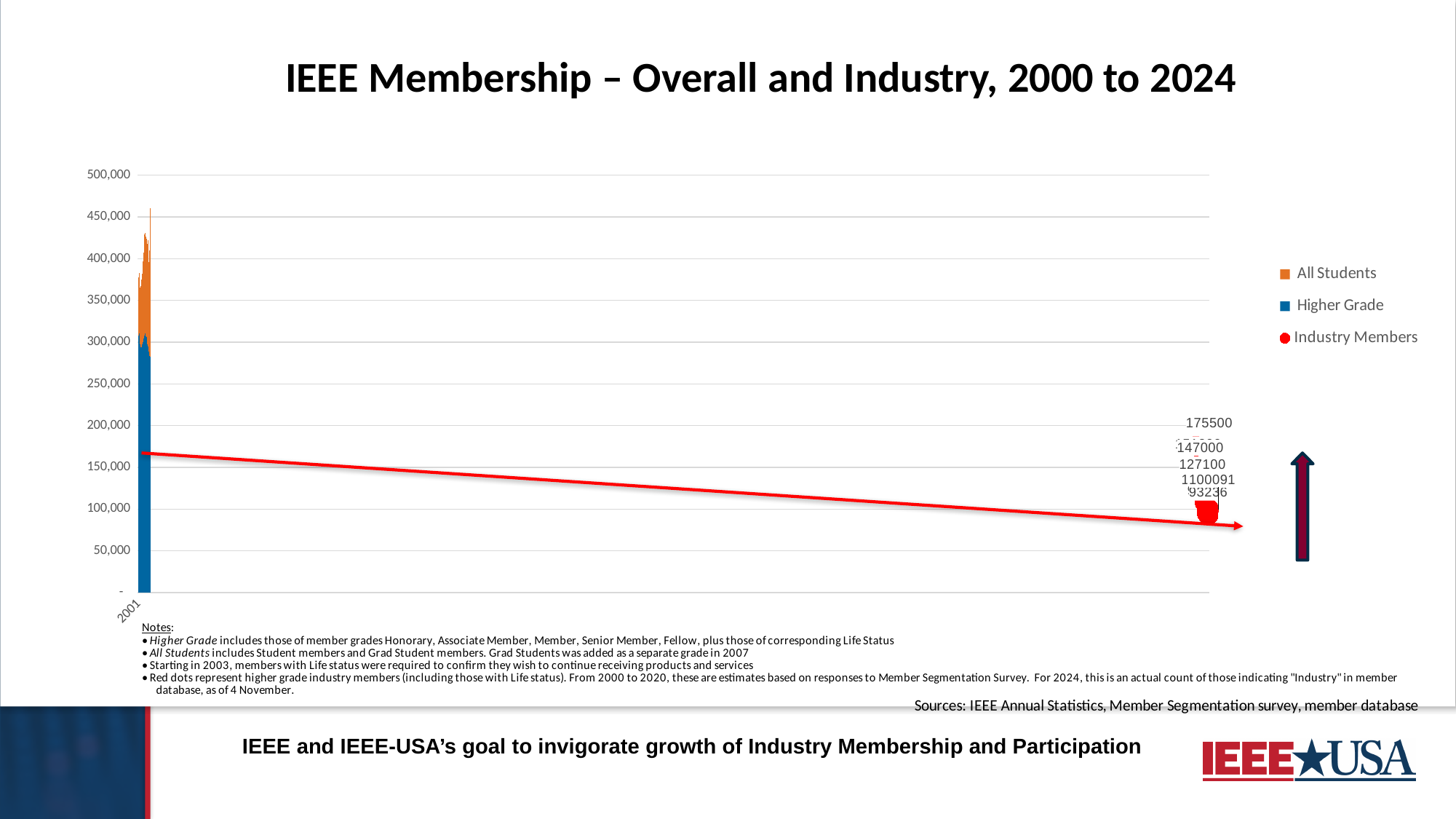
Which printed Industry Members label is larger, 147000 or 127100? 147000 Is the top of the stacked bar for 2001 greater or less than 350,000? greater How many series does the chart legend list? 3 What is the lowest data label printed for the Industry Members series? 93236 What kind of chart is used for the All Students and Higher Grade series? Bar chart What is the title of the chart? IEEE Membership – Overall and Industry, 2000 to 2024 Is the Higher Grade bar for 2001 greater or less than 250,000? greater What is the difference between the printed Industry Members labels 175500 and 147000? 28500 What is the highest data label printed for the Industry Members series? 175500 What colour represents Industry Members in the chart? Red According to the red arrow, do Industry Members rise or fall from left to right across the chart? Fall